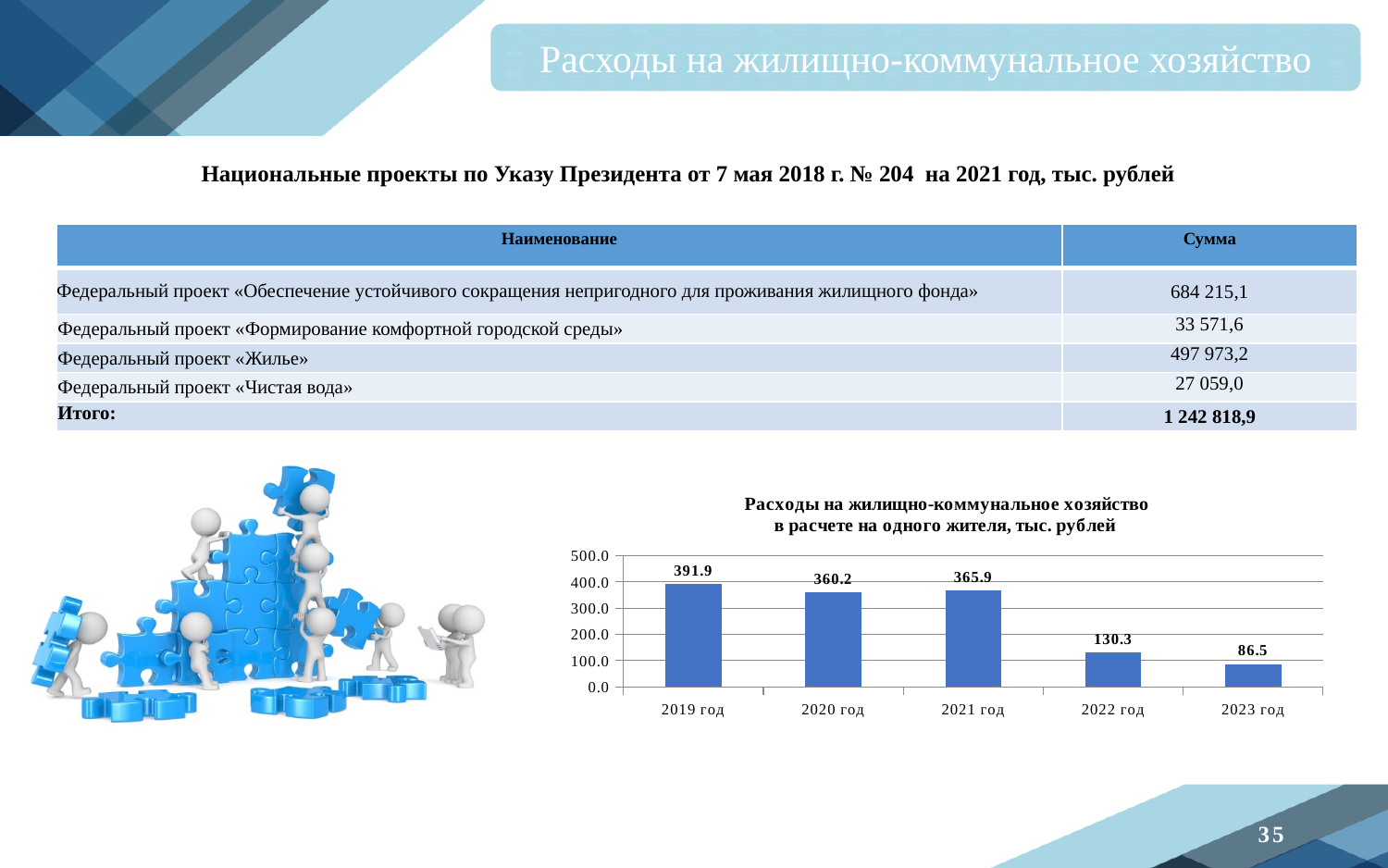
What is the difference between the values for 2021 год and 2020 год? 5.7 What is the value for 2023 год? 86.5 Is the value for 2020 год greater or less than 300.0? greater Which is larger, the value for 2021 год or the value for 2022 год? 2021 год What kind of chart is shown on the slide? bar chart How many years are shown on the x axis? 5 Which year has the lowest value? 2023 год What is the value for 2022 год? 130.3 Which year has the highest value? 2019 год What is the title of the chart? Расходы на жилищно-коммунальное хозяйство в расчете на одного жителя, тыс. рублей What is the difference between the values for 2019 год and 2023 год? 305.4 What is the value for 2019 год? 391.9